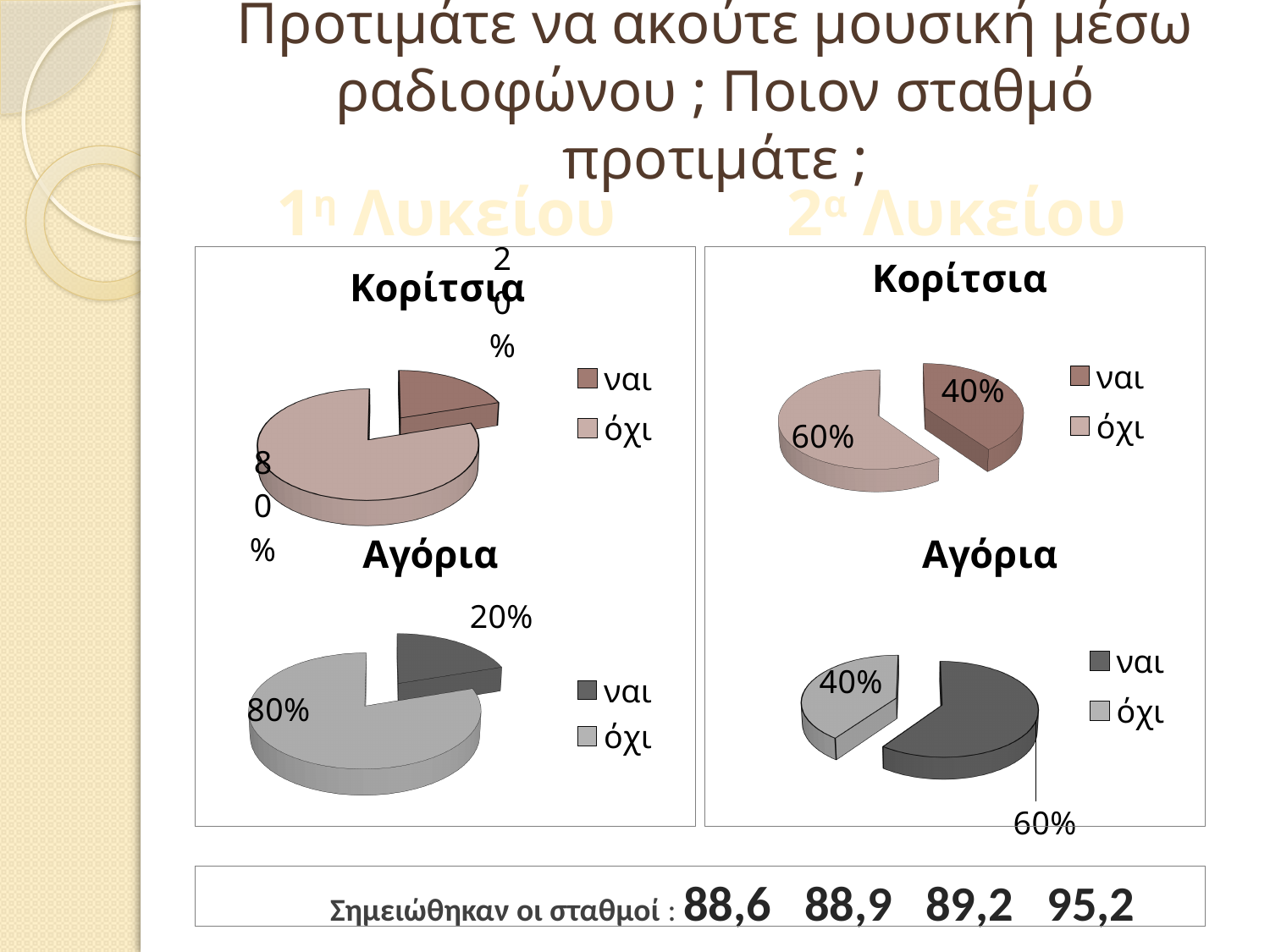
In the bottom-left pie chart (Αγόρια, 1η Λυκείου), what is the difference between the όχι and ναι percentages? 60% In the top-right pie chart (Κορίτσια, 2α Λυκείου), what percentage is shown for όχι? 60% In the bottom-right pie chart (Αγόρια, 2α Λυκείου), which slice is larger, ναι or όχι? ναι How many entries does the legend of the top-right pie chart (Κορίτσια, 2α Λυκείου) list? 2 In the top-right pie chart (Κορίτσια, 2α Λυκείου), what percentage is shown for ναι? 40% What type of chart is used for the Αγόρια (2α Λυκείου) data in the bottom-right? Pie chart In the bottom-left pie chart (Αγόρια, 1η Λυκείου), what percentage is shown for ναι? 20% In the bottom-left pie chart (Αγόρια, 1η Λυκείου), what percentage is shown for όχι? 80% In the top-left pie chart (Κορίτσια, 1η Λυκείου), what percentage is shown for ναι? 20% In the top-left pie chart (Κορίτσια, 1η Λυκείου), what percentage is shown for όχι? 80% In the bottom-right pie chart (Αγόρια, 2α Λυκείου), what percentage is shown for ναι? 60% In the bottom-left pie chart (Αγόρια, 1η Λυκείου), which slice is the largest? όχι